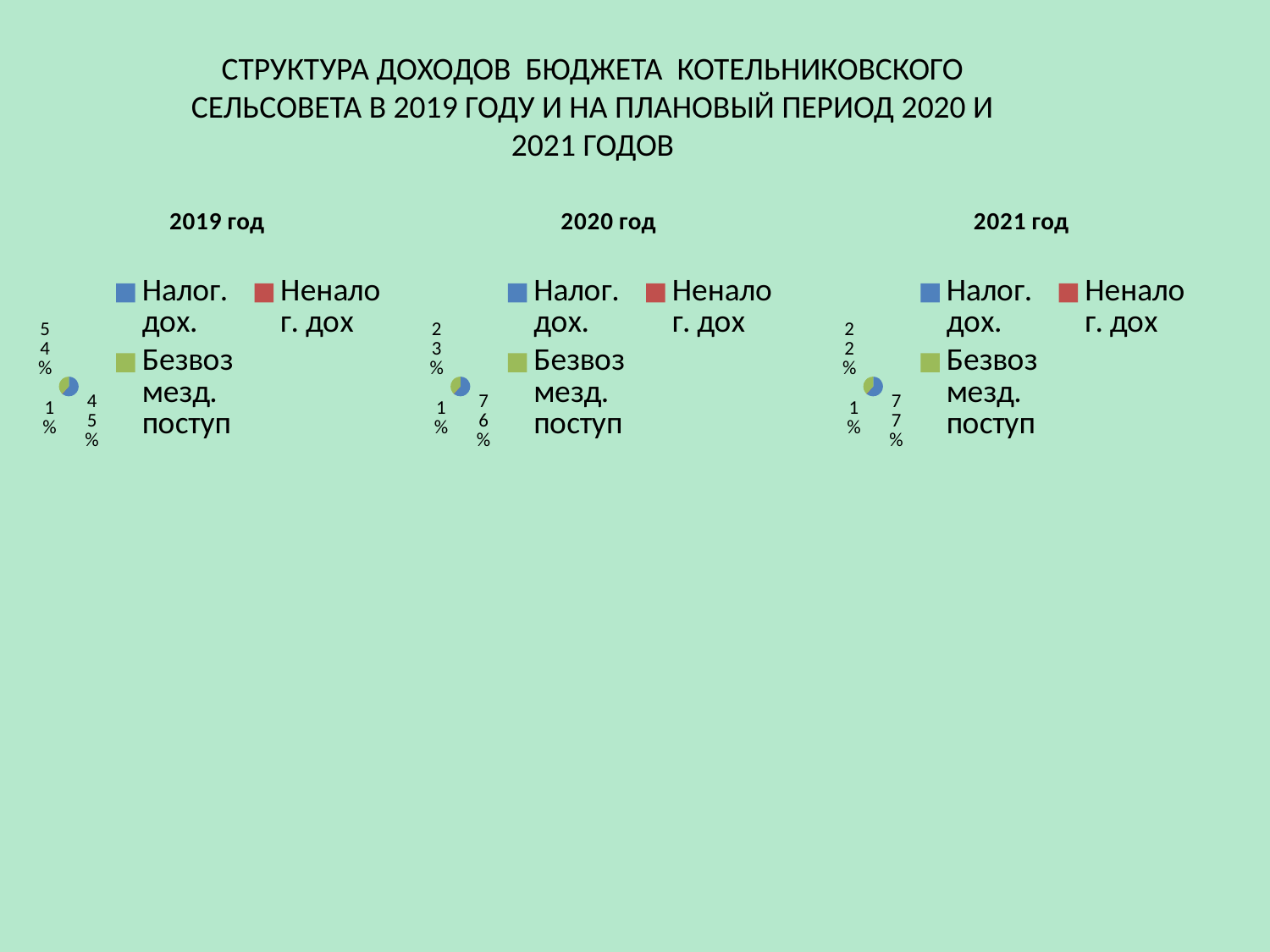
What is the largest percentage label shown on the 2021 год pie chart? 77% What is the largest percentage label shown on the 2019 год pie chart? 54% What is the title of the middle chart on the slide? 2020 год What is the smallest percentage label shown on the 2021 год pie chart? 1% On the 2019 год pie chart, what is the difference between the two largest labelled shares, 54% and 45%? 9 percentage points What colour represents Налог. дох. in the legend of the 2021 год chart? blue How many series does the legend of the 2020 год chart list? 3 Which is larger: the largest share on the 2020 год pie chart or the largest share on the 2021 год pie chart? 2021 год (77%) How many pie charts are shown on the slide? 3 What is the smallest percentage label shown on the 2019 год pie chart? 1% What is the largest percentage label shown on the 2020 год pie chart? 76% What kind of chart is used for the 2019 год chart? pie chart